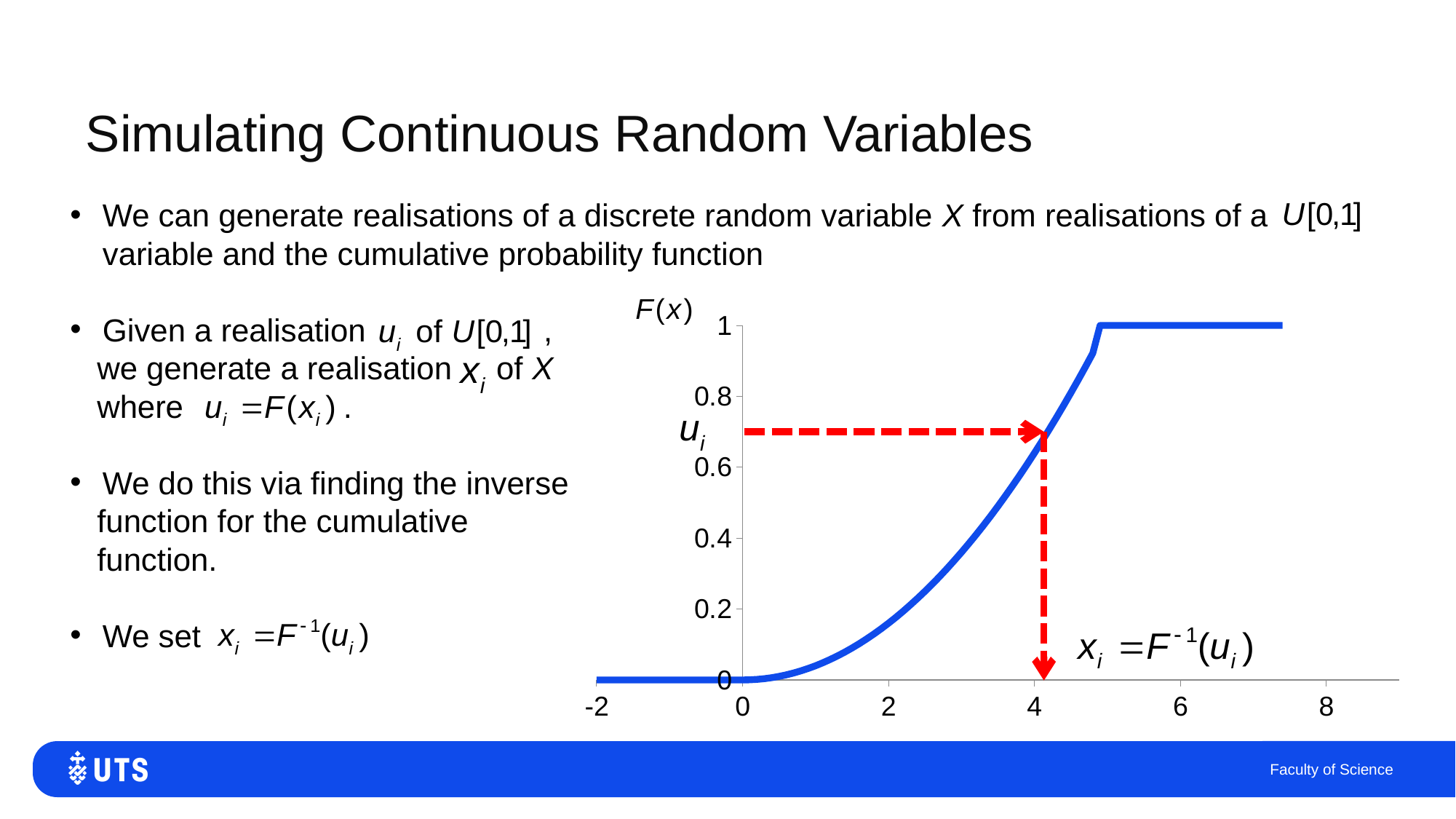
What is the value of F(x) at x = 6? 1 How many labelled tick marks are on the horizontal axis? 6 What is the lowest tick value shown on the horizontal axis? -2 What is the label on the vertical axis of the chart? F(x) What is the highest tick value shown on the vertical axis? 1 Is the value of F(x) at x = 6 greater or less than 0.8? greater Is the value of F(x) at x = 4 greater or less than 0.4? greater What kind of chart is shown on the slide? line chart What is the value of F(x) at x = -2? 0 Does the plotted curve rise or fall as x increases from 0 to 5? rise What is the highest tick value shown on the horizontal axis? 8 Is the value of F(x) at x = 0 greater or less than 0.2? less